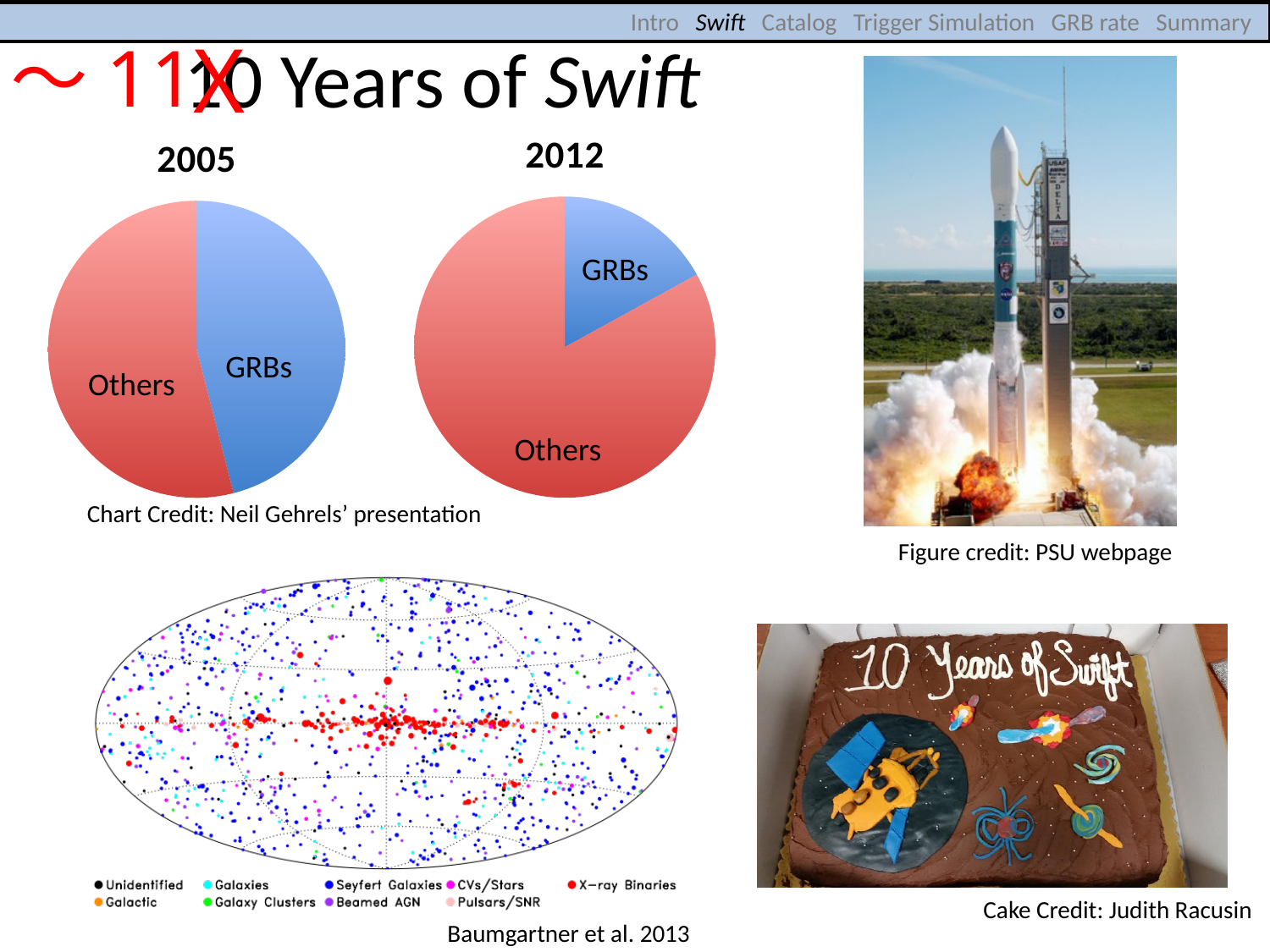
In the 2012 pie chart, which category has the largest slice? Others In the 2012 pie chart, which slice is larger, GRBs or Others? Others Who is credited for the pie charts? Neil Gehrels' presentation In the 2012 pie chart, which category has the smallest slice? GRBs How many slices does the 2012 pie chart have? 2 What kind of chart is the 2012 chart? Pie chart What kind of chart is the 2005 chart? Pie chart Does the share of GRBs increase or decrease from the 2005 pie chart to the 2012 pie chart? Decrease What colour is the GRBs slice in the pie charts? Blue In the 2012 pie chart, is the GRBs slice more or less than half of the pie? Less Is the GRBs slice larger in the 2005 pie chart or in the 2012 pie chart? 2005 How many slices does the 2005 pie chart have? 2